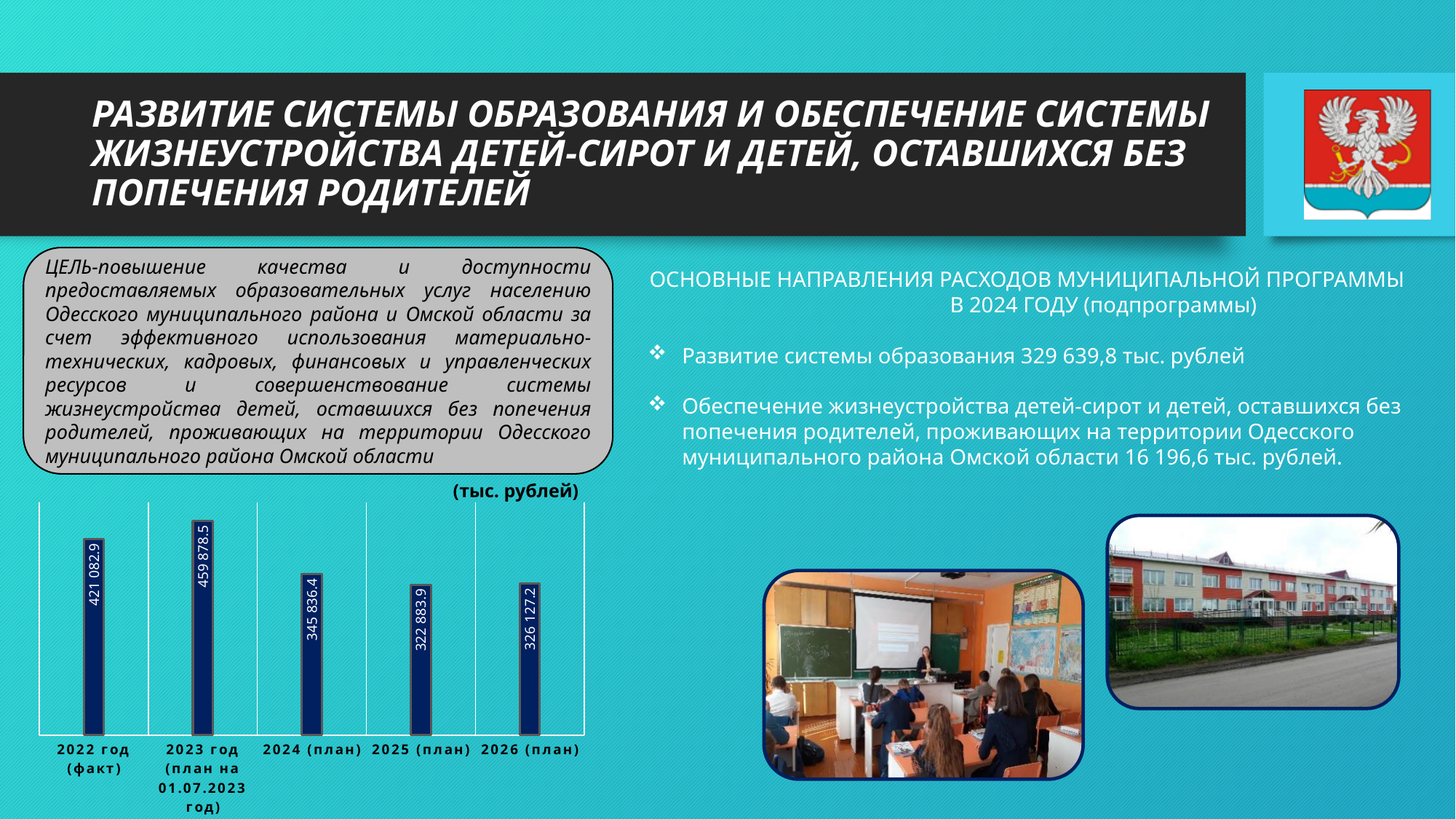
What value is shown for 2022 год (факт) in the bar chart? 421 082.9 What value is shown for 2026 (план) in the bar chart? 326 127.2 Which category has the highest value in the bar chart? 2023 год (план на 01.07.2023 год) How many categories are shown in the bar chart? 5 What value is shown for 2024 (план) in the bar chart? 345 836.4 Do the values in the bar chart rise or fall from 2023 год (план на 01.07.2023 год) to 2025 (план)? fall What is the difference between the values for 2023 год (план на 01.07.2023 год) and 2022 год (факт)? 38 795.6 What kind of chart is shown on the slide? bar chart What is the difference between the values for 2024 (план) and 2025 (план)? 22 952.5 Which is larger, the value for 2025 (план) or the value for 2026 (план)? 2026 (план) Which category has the lowest value in the bar chart? 2025 (план) Which is larger, the value for 2022 год (факт) or the value for 2024 (план)? 2022 год (факт)